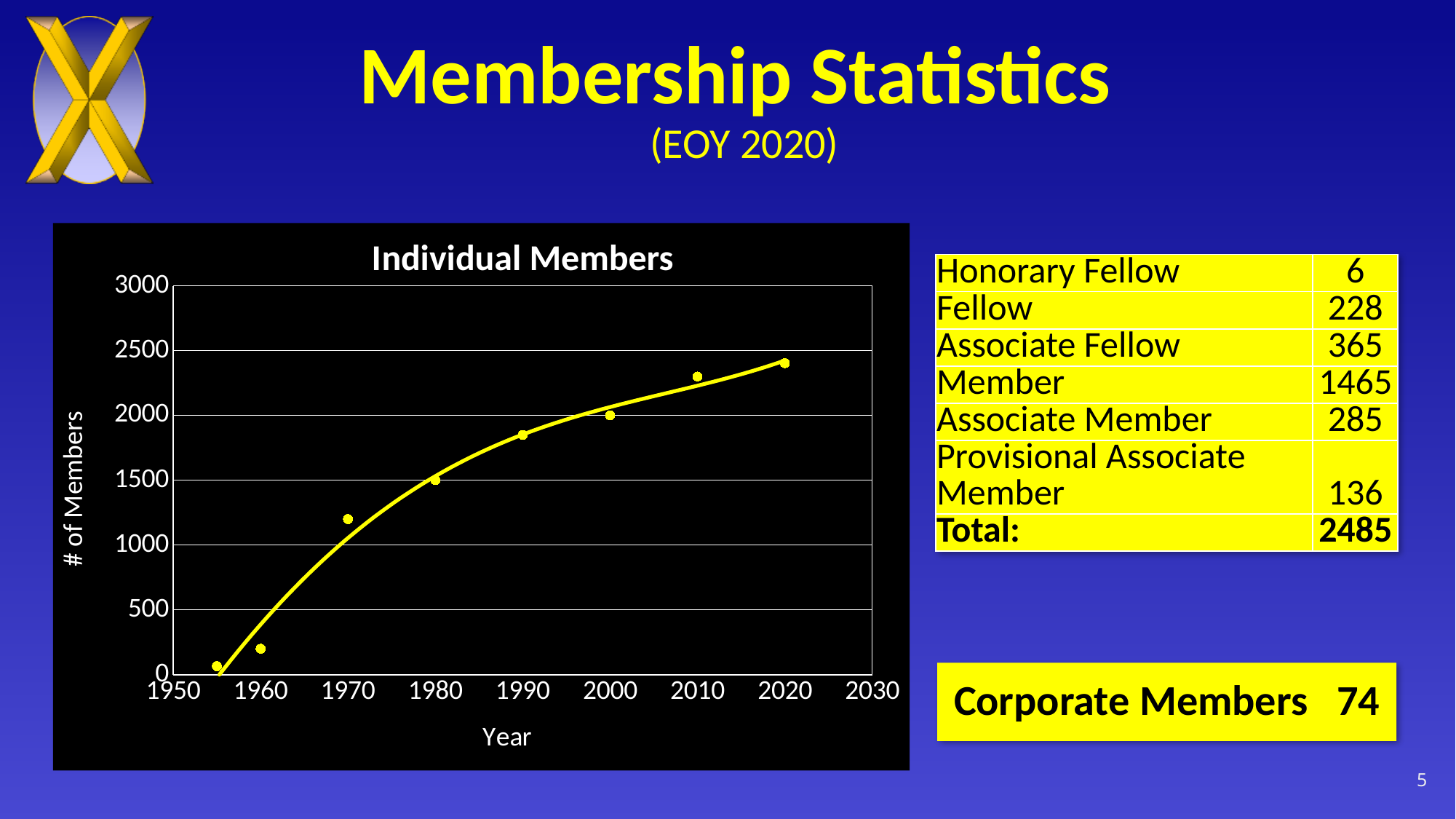
Do the values in the Individual Members chart rise or fall as the year increases? rise Is the value for 2010 greater or less than 2000? greater Is the value for 1970 greater or less than 1000? greater Is the value for 1960 greater or less than 500? less What kind of chart is shown on the slide? scatter chart Which year has the highest number of individual members in the chart? 2020 How many data points are plotted in the Individual Members chart? 8 What is the label of the y axis of the chart? # of Members What is the title of the chart? Individual Members Which year has more individual members, 1990 or 2010? 2010